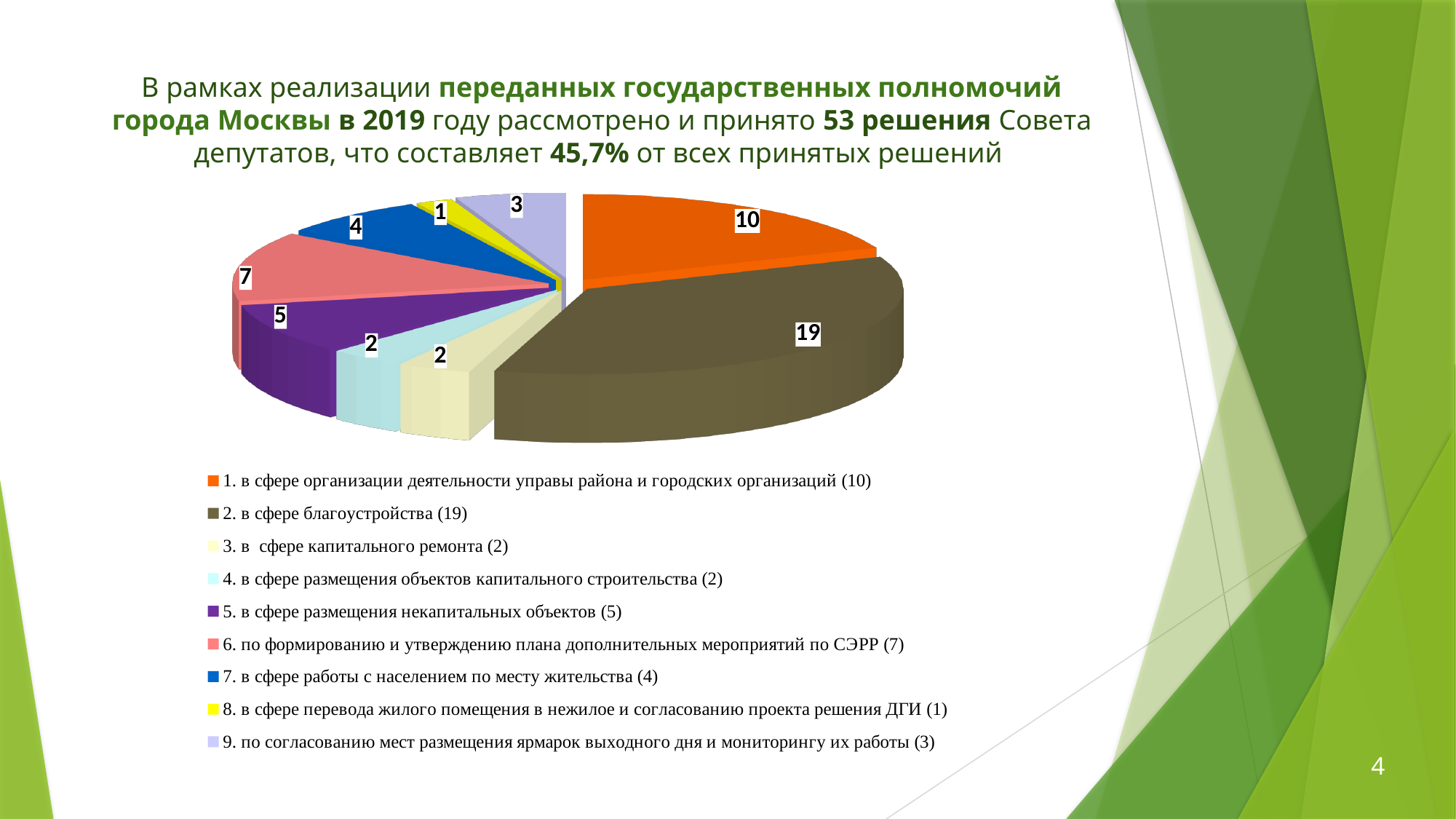
What colour is the slice for "2. в сфере благоустройства"? brown What is the difference between the value for "2. в сфере благоустройства" and the value for "1. в сфере организации деятельности управы района и городских организаций"? 9 How many slices does the pie chart have? 9 Which is larger: the value for "6. по формированию и утверждению плана дополнительных мероприятий по СЭРР" or the value for "5. в сфере размещения некапитальных объектов"? 6. по формированию и утверждению плана дополнительных мероприятий по СЭРР What is the total of all the slice values in the pie chart? 53 How many decisions were taken in the category "2. в сфере благоустройства"? 19 Which category has the largest slice of the pie? 2. в сфере благоустройства Which category has the smallest slice of the pie? 8. в сфере перевода жилого помещения в нежилое и согласованию проекта решения ДГИ What is the value for "9. по согласованию мест размещения ярмарок выходного дня и мониторингу их работы"? 3 What kind of chart is shown on the slide? pie chart What is the difference between the value for "6. по формированию и утверждению плана дополнительных мероприятий по СЭРР" and the value for "7. в сфере работы с населением по месту жительства"? 3 What is the value for "7. в сфере работы с населением по месту жительства"? 4